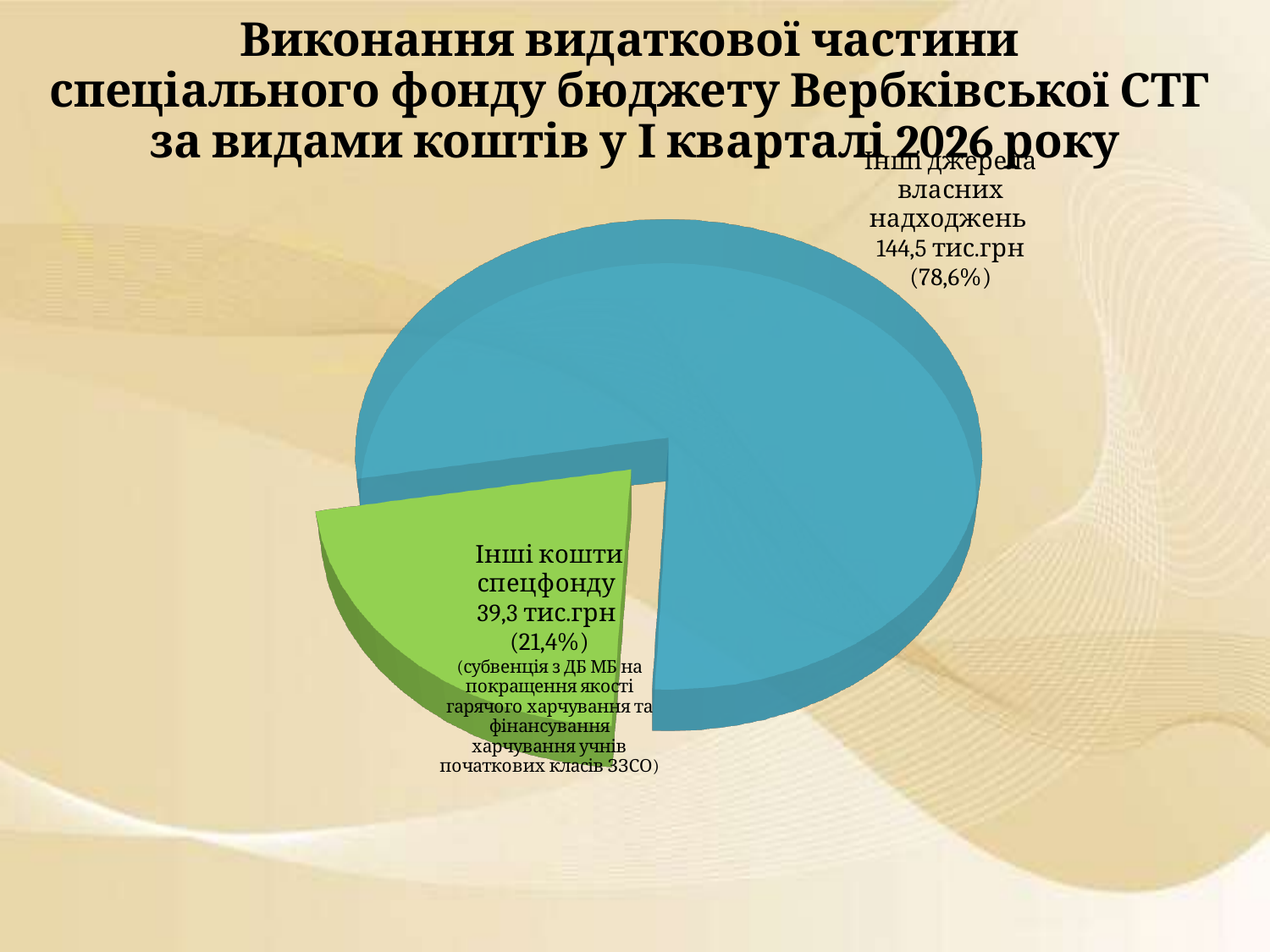
What colour is the slice for "Інші кошти спецфонду"? green How many slices does the pie chart have? 2 What share of the pie does "Інші джерела власних надходжень" represent? 78,6% What is the value for "Інші кошти спецфонду"? 39,3 тис.грн What share of the pie does "Інші кошти спецфонду" represent? 21,4% What is the value for "Інші джерела власних надходжень"? 144,5 тис.грн What is the total of the two slices in тис.грн? 183,8 тис.грн What kind of chart is shown on the slide? pie chart Which slice of the pie chart is the largest? Інші джерела власних надходжень Which slice of the pie chart is the smallest? Інші кошти спецфонду What is the difference in тис.грн between "Інші джерела власних надходжень" and "Інші кошти спецфонду"? 105,2 тис.грн Which is larger: "Інші джерела власних надходжень" or "Інші кошти спецфонду"? Інші джерела власних надходжень